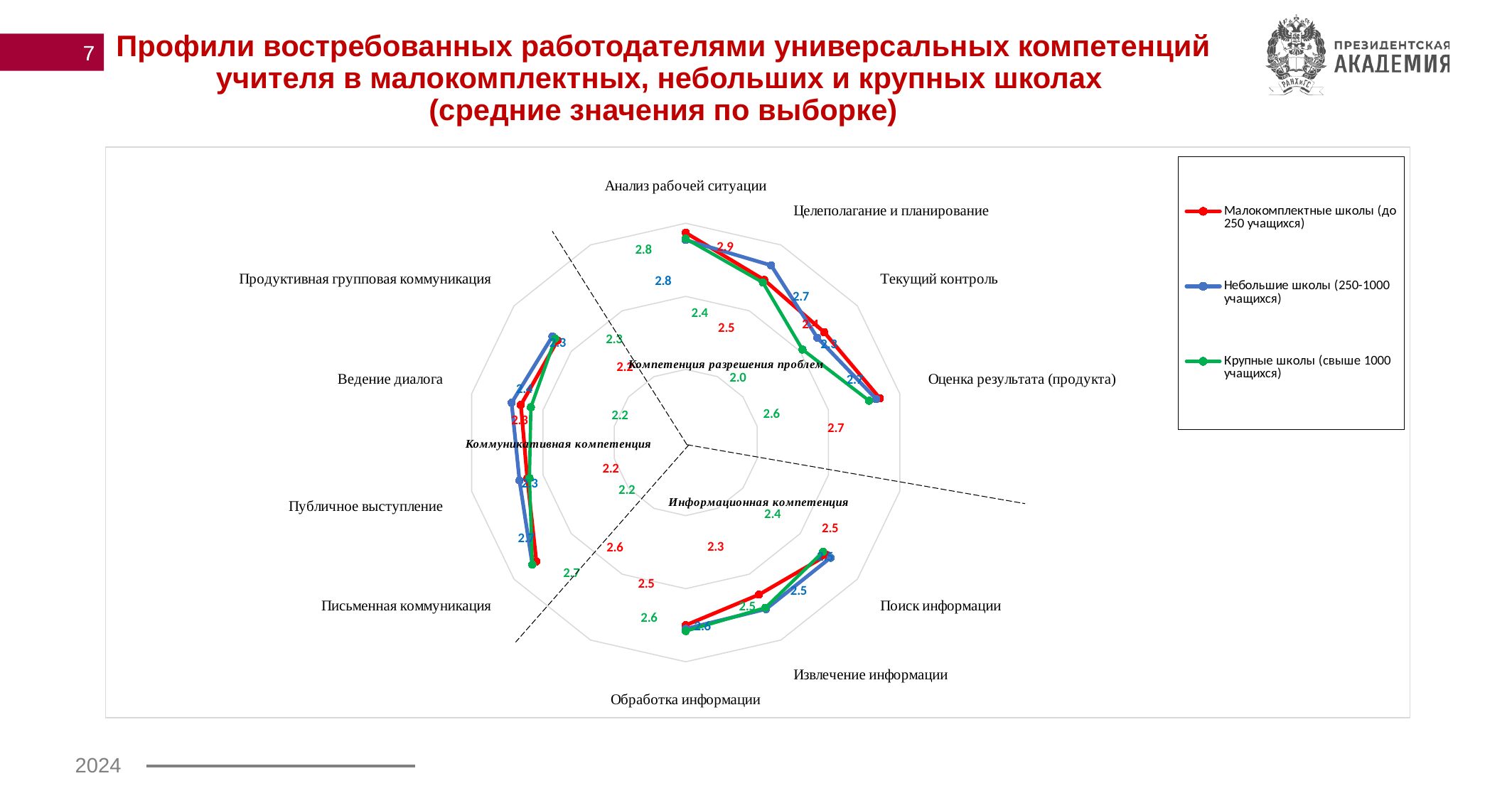
For Текущий контроль, which series has the lowest value? Крупные школы (свыше 1000 учащихся) How many competency categories are plotted around the radar chart? 11 How many series does the legend list? 3 Which series is drawn in red according to the legend? Малокомплектные школы (до 250 учащихся) For Ведение диалога, which series has the highest value? Небольшие школы (250-1000 учащихся) For Целеполагание и планирование, which is larger: the value for Небольшие школы (250-1000 учащихся) or for Крупные школы (свыше 1000 учащихся)? Небольшие школы (250-1000 учащихся) For Ведение диалога, which is larger: the value for Небольшие школы (250-1000 учащихся) or for Крупные школы (свыше 1000 учащихся)? Небольшие школы (250-1000 учащихся) What kind of chart is shown on the slide? Radar chart Which series is drawn in green according to the legend? Крупные школы (свыше 1000 учащихся)